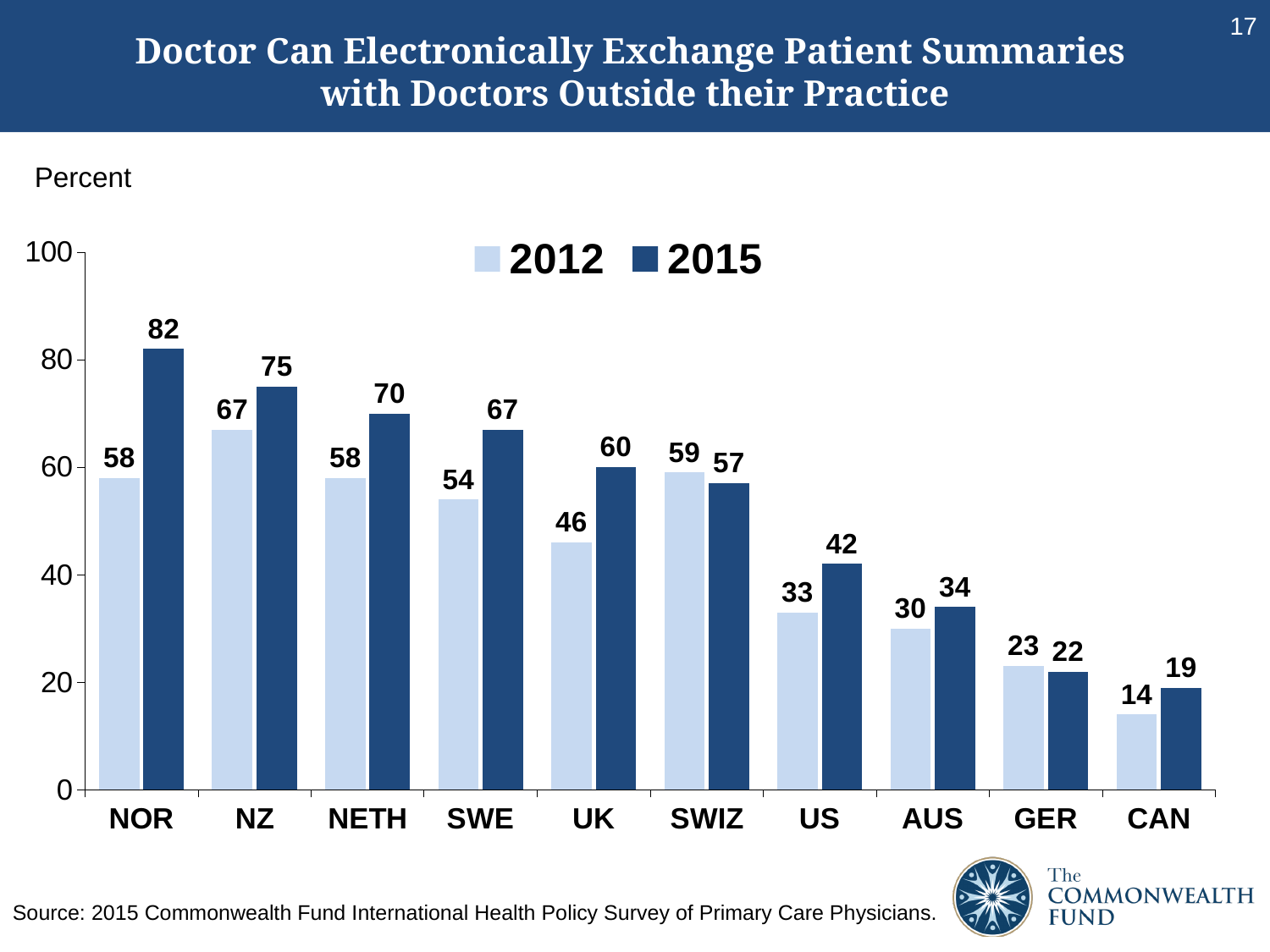
Do the 2015 values generally rise or fall from left to right along the x axis? Fall What is the difference between the 2015 and 2012 values for UK? 14 What is the 2015 value for NOR? 82 How many series does the legend list? 2 What is the 2012 value for CAN? 14 How many countries are shown on the x axis? 10 Which country has the lowest 2012 value? CAN What is the 2012 value for SWE? 54 Which country has the highest 2015 value? NOR What are the two years listed in the legend? 2012 and 2015 What kind of chart is shown on the slide? Bar chart For SWIZ, which is larger, the 2012 value or the 2015 value? 2012